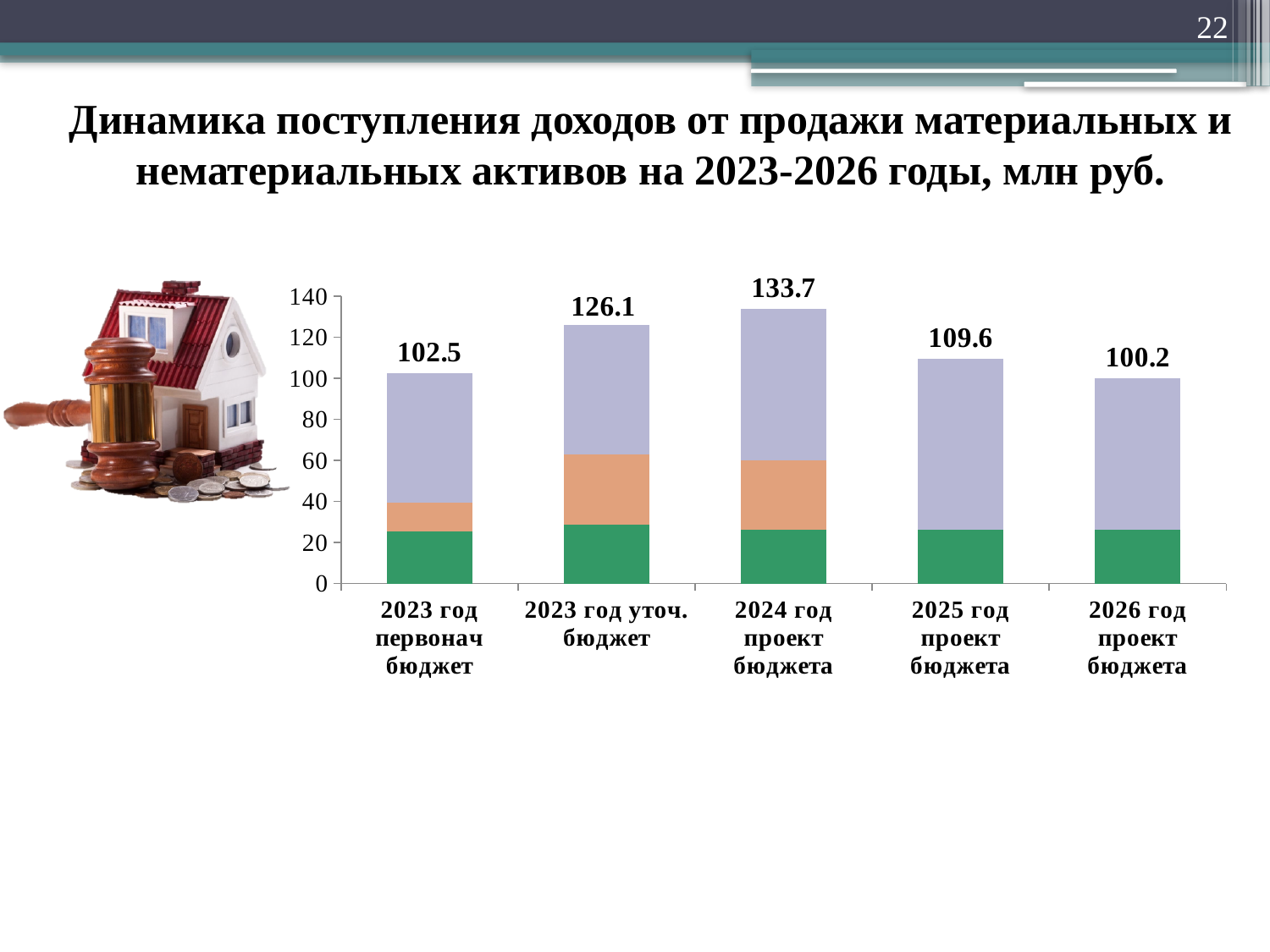
Which category has the highest value? 2024 год проект бюджета What is the value for 2023 год первонач бюджет? 102.5 Which is larger, the value for 2023 год уточ. бюджет or the value for 2025 год проект бюджета? 2023 год уточ. бюджет Is the green segment of the bar for 2025 год проект бюджета greater or less than 20? greater What kind of chart is shown on the slide? Stacked bar chart What is the difference between the values for 2024 год проект бюджета and 2023 год первонач бюджет? 31.2 What is the difference between the values for 2025 год проект бюджета and 2026 год проект бюджета? 9.4 What is the value for 2026 год проект бюджета? 100.2 Which category has the lowest value? 2026 год проект бюджета What is the value for 2024 год проект бюджета? 133.7 Do the values rise or fall from 2024 год проект бюджета to 2026 год проект бюджета? Fall How many categories are shown on the x axis? 5